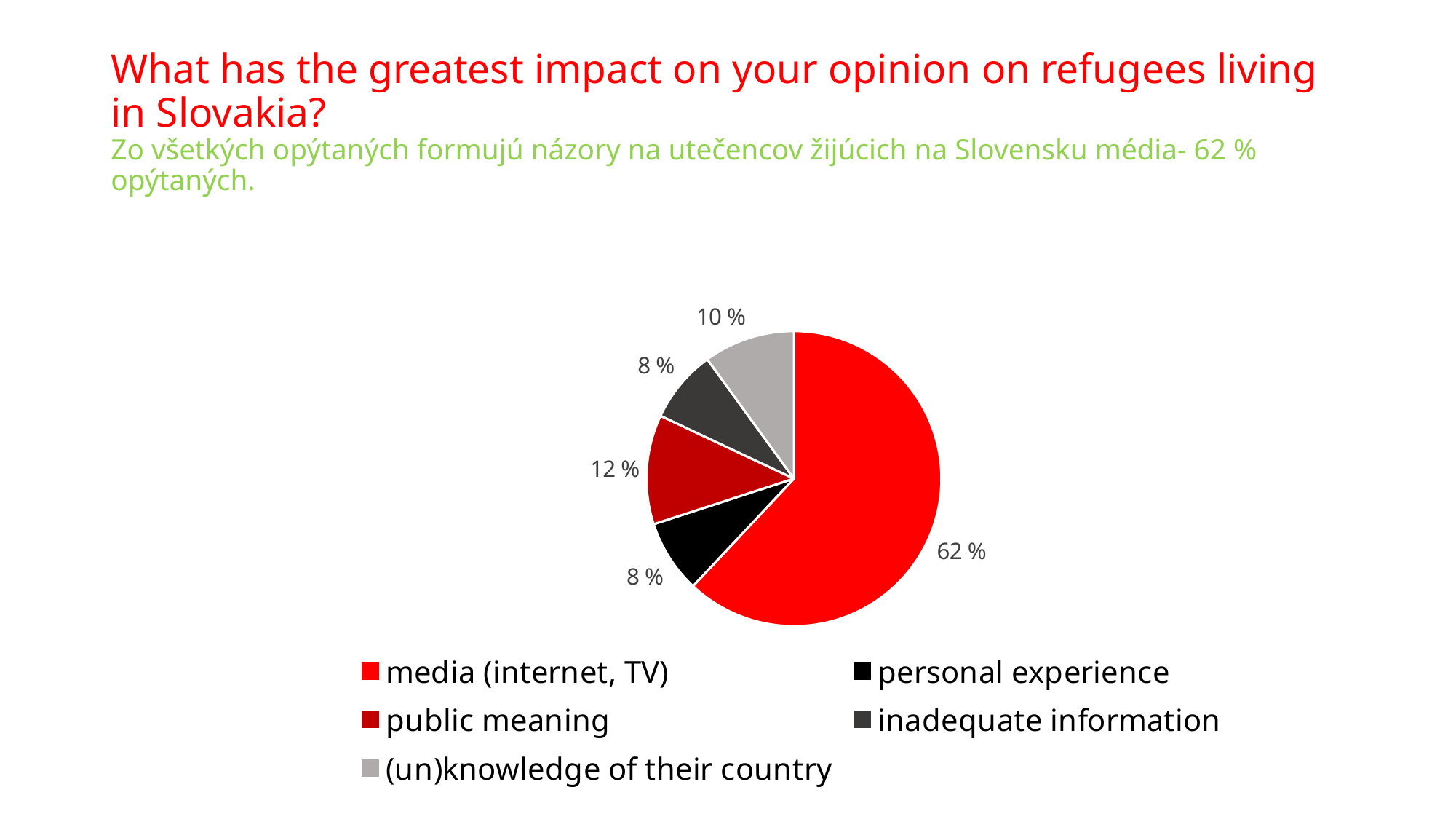
What is the difference between the share for (un)knowledge of their country and the share for personal experience? 2 % What share of respondents chose (un)knowledge of their country? 10 % What kind of chart is shown on the slide? pie chart What share of respondents chose public meaning? 12 % What is the difference between the share for media (internet, TV) and the share for public meaning? 50 % What share of respondents chose personal experience? 8 % Which colour represents media (internet, TV) in the legend? red What share of respondents chose media (internet, TV)? 62 % How many categories does the pie chart show? 5 Which is larger, the share for public meaning or the share for (un)knowledge of their country? public meaning Which category has the largest slice of the pie? media (internet, TV) What share of respondents chose inadequate information? 8 %